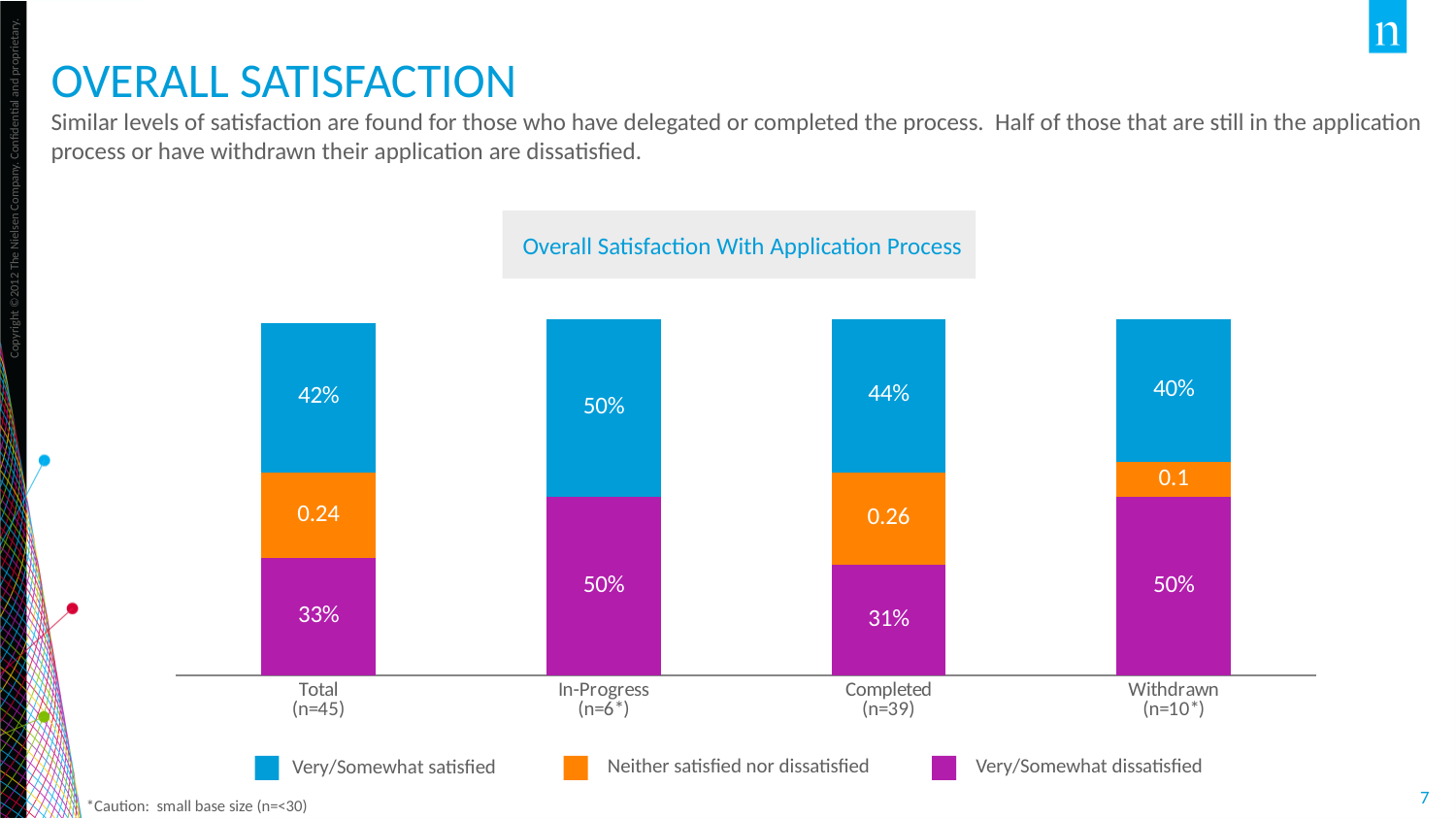
Which category has the highest Very/Somewhat satisfied value? In-Progress (n=6*) How many series does the legend list? 3 How many categories are shown along the x axis? 4 What is the Very/Somewhat dissatisfied value for Completed (n=39)? 31% What is the Very/Somewhat satisfied value for Total (n=45)? 42% What is the Neither satisfied nor dissatisfied value shown for Completed (n=39)? 0.26 Which category has the lowest Very/Somewhat dissatisfied value? Completed (n=39) What is the Neither satisfied nor dissatisfied value shown for Withdrawn (n=10*)? 0.1 What is the difference between the Very/Somewhat dissatisfied values for Withdrawn (n=10*) and Completed (n=39)? 19 percentage points What is the chart's title? Overall Satisfaction With Application Process What type of chart is shown on the slide? Stacked bar chart Which is larger, the Very/Somewhat satisfied value for Completed (n=39) or for Withdrawn (n=10*)? Completed (n=39)